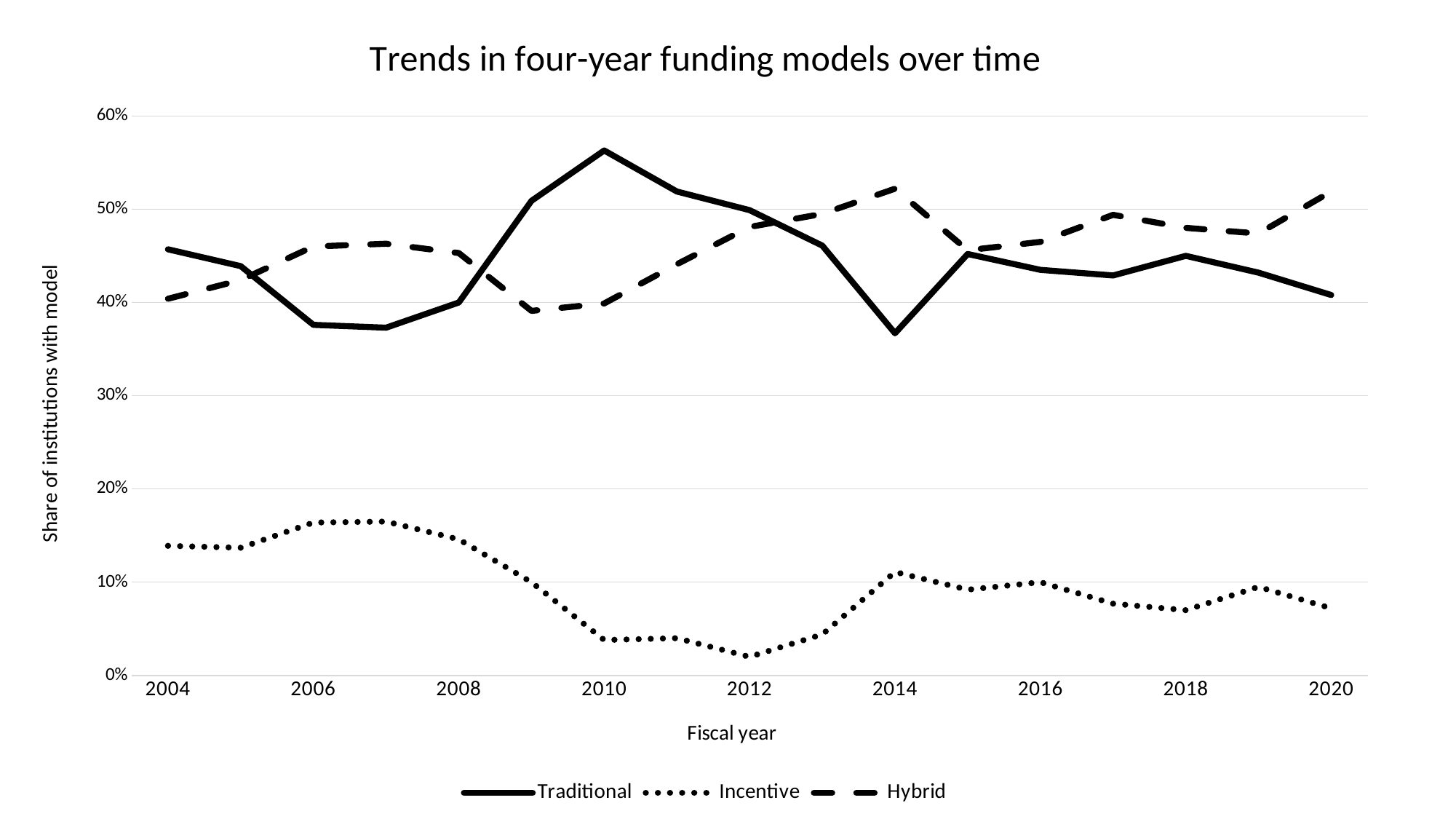
Which series is drawn with a dotted line? Incentive Is the value for Traditional in 2010 greater or less than 50%? greater What is the title of the chart? Trends in four-year funding models over time In which fiscal year does the Incentive series reach its lowest value? 2012 Is the value for Incentive in 2006 greater or less than 10%? greater Is the value for Hybrid in 2014 greater or less than 50%? greater Does the Incentive series rise or fall between 2006 and 2012? fall In 2020, which series has the higher value, Traditional or Hybrid? Hybrid What kind of chart is shown on the slide? line chart How many series does the legend list? 3 In which fiscal year does the Traditional series reach its highest value? 2010